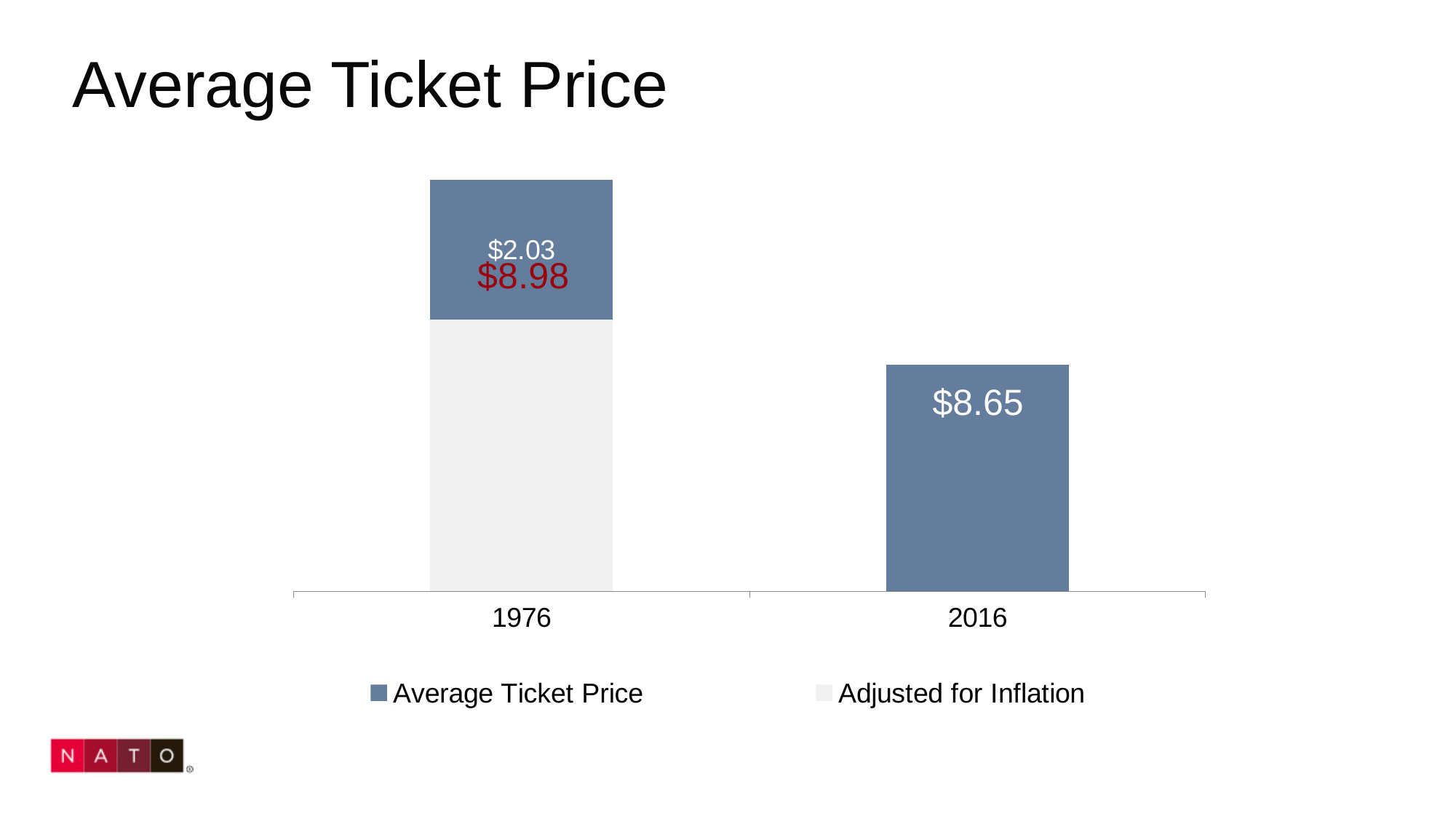
How many series does the legend list? 2 How many years are shown on the x axis? 2 Which series is shown in light grey in the legend? Adjusted for Inflation What kind of chart is shown on the slide? Stacked bar chart What red value is printed on the 1976 bar? $8.98 What is the Average Ticket Price for 2016? $8.65 Which year has the taller overall bar? 1976 What is the title of the chart? Average Ticket Price What is the difference between the Average Ticket Price in 2016 and in 1976? $6.62 Which year has the higher Average Ticket Price, 1976 or 2016? 2016 Does the Average Ticket Price rise or fall from 1976 to 2016? Rise What is the Average Ticket Price for 1976? $2.03